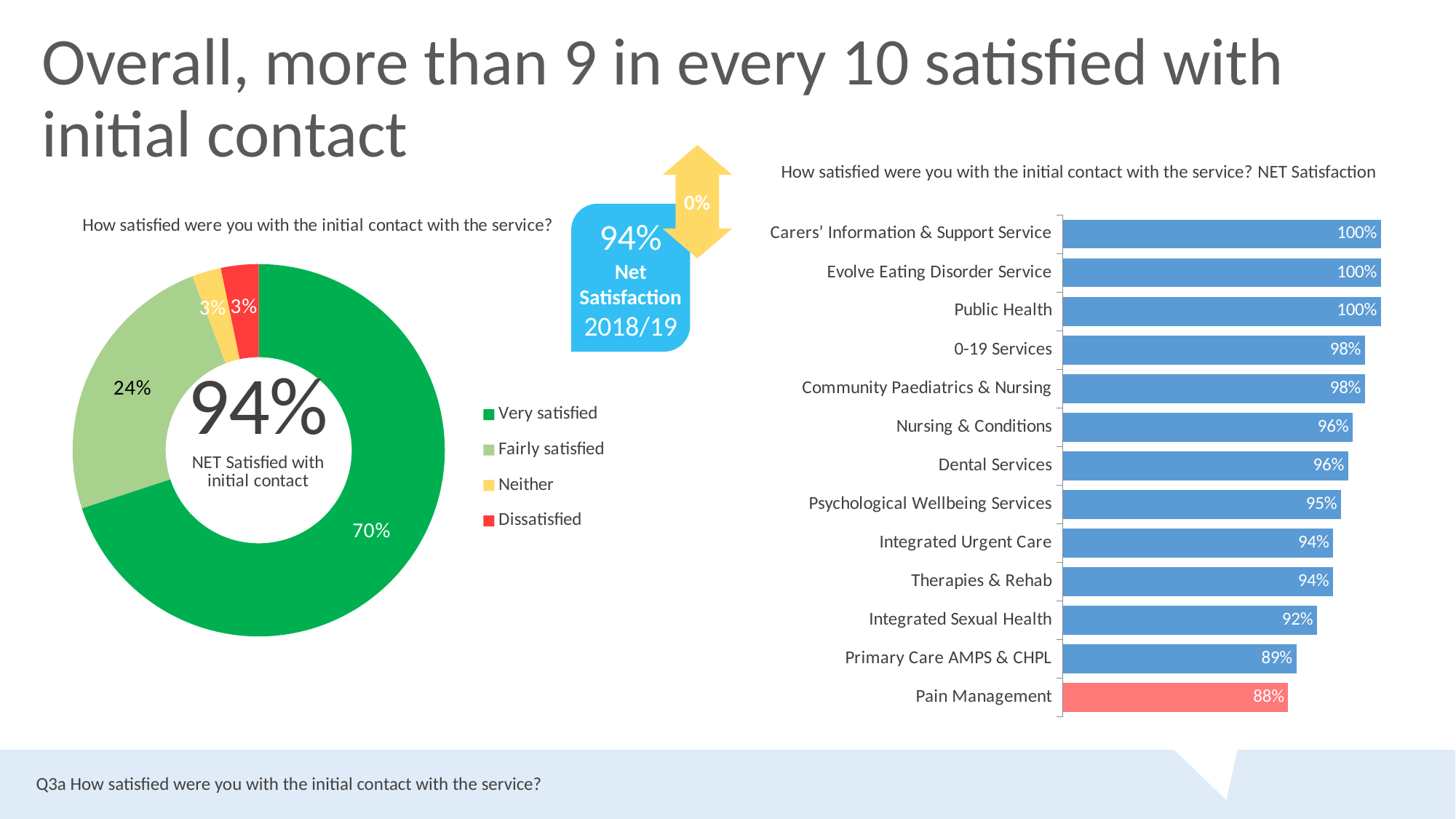
In the bar chart on the right, which service has the lowest NET satisfaction? Pain Management In the pie chart on the left, what percentage of respondents were dissatisfied? 3% In the bar chart on the right, how many services are shown? 13 What kind of chart is shown on the right side of the slide? Bar chart In the bar chart on the right, what is the difference between the NET satisfaction for Public Health and Primary Care AMPS & CHPL? 11% In the pie chart on the left, which category has the largest share? Very satisfied In the pie chart on the left, what percentage of respondents were fairly satisfied? 24% In the pie chart on the left, what percentage of respondents were very satisfied with the initial contact? 70% In the bar chart on the right, what is the NET satisfaction value for Integrated Sexual Health? 92% In the pie chart on the left, how many categories does the legend list? 4 In the bar chart on the right, which has a higher NET satisfaction: Dental Services or Integrated Urgent Care? Dental Services In the bar chart on the right, what is the NET satisfaction value for Pain Management? 88%